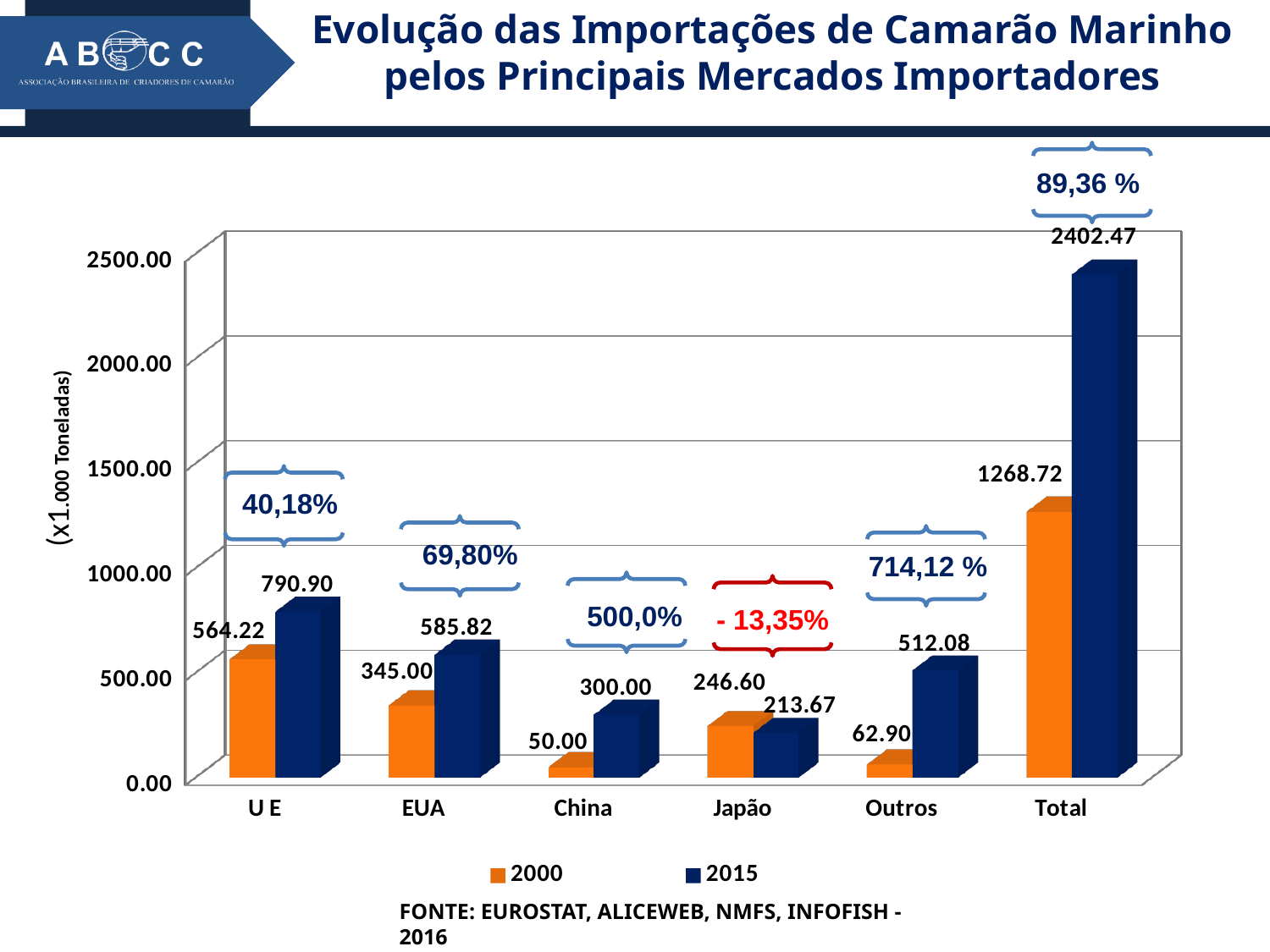
How many series does the legend list? 2 For Japão, which is larger: the 2000 value or the 2015 value? 2000 What kind of chart is shown on the slide? Bar chart What is the value for Outros in the 2015 series? 512.08 What is the value for U E in the 2015 series? 790.90 How many categories are shown on the x axis? 6 What is the difference between the 2015 and 2000 values for EUA? 240.82 What is the difference between the 2015 and 2000 values for Total? 1133.75 What percentage change is annotated above the Outros bars? 714,12 % Excluding Total, which category has the highest value in the 2015 series? U E Which category has the lowest value in the 2000 series? China What is the value for China in the 2000 series? 50.00